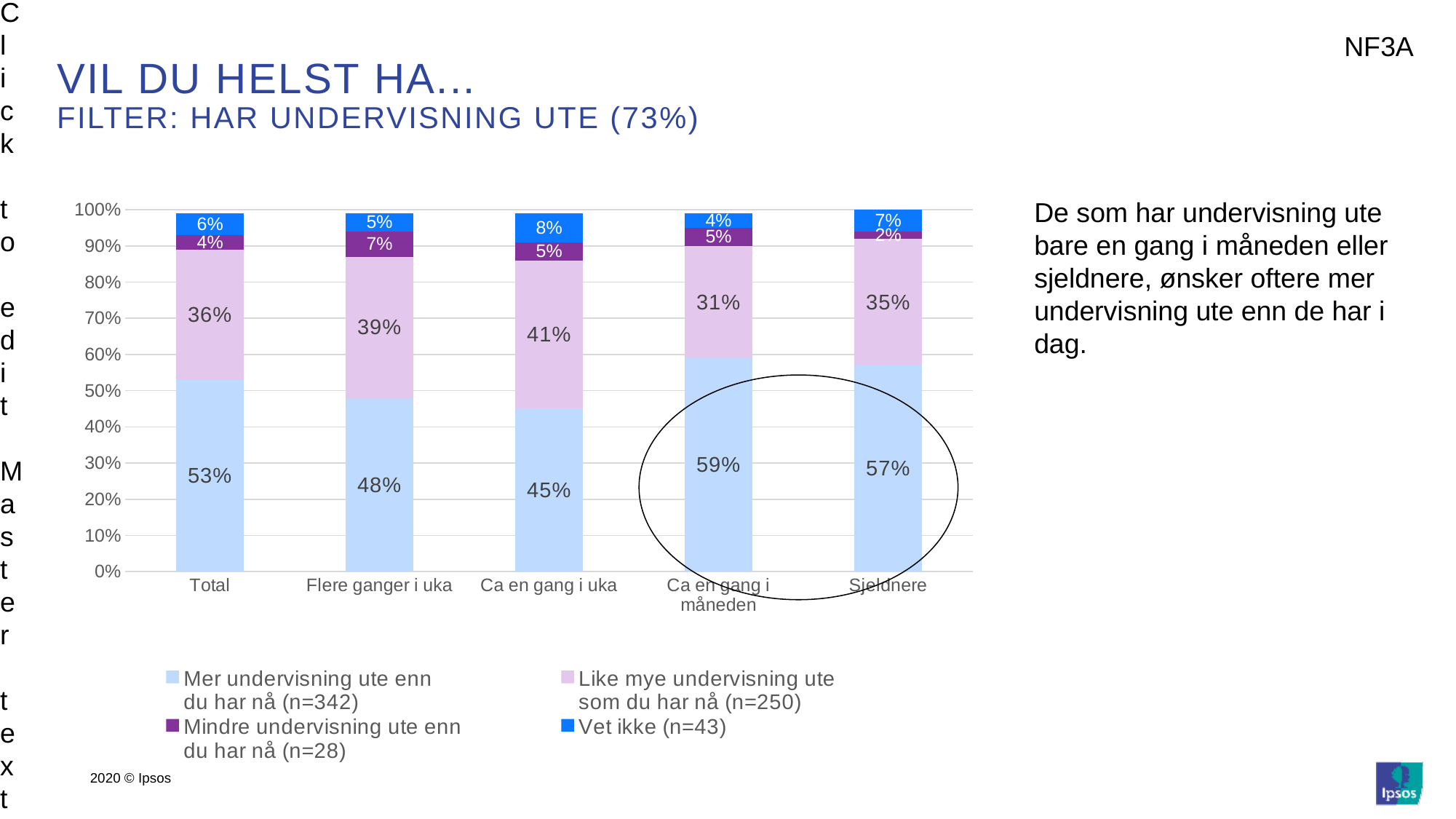
According to the legend, what is the sample size (n) for the 'Vet ikke' series? n=43 How many percentage points higher is the 'Mer undervisning ute enn du har nå' share for 'Total' than for 'Ca en gang i uka'? 8 percentage points What is the 'Vet ikke' share for the 'Sjeldnere' category? 7% How many categories are shown on the x axis of the chart? 5 Which category has the lowest share of 'Mindre undervisning ute enn du har nå'? Sjeldnere Which category has the highest share of 'Mer undervisning ute enn du har nå'? Ca en gang i måneden What is the value for 'Like mye undervisning ute som du har nå' in the 'Ca en gang i uka' category? 41% What is the 'Mindre undervisning ute enn du har nå' value for 'Flere ganger i uka'? 7% What percentage of respondents in the 'Ca en gang i måneden' group want 'Mer undervisning ute enn du har nå'? 59% Which has a larger 'Like mye undervisning ute som du har nå' share: 'Flere ganger i uka' or 'Sjeldnere'? Flere ganger i uka How many series does the legend list? 4 What type of chart is shown on the slide? Stacked bar chart